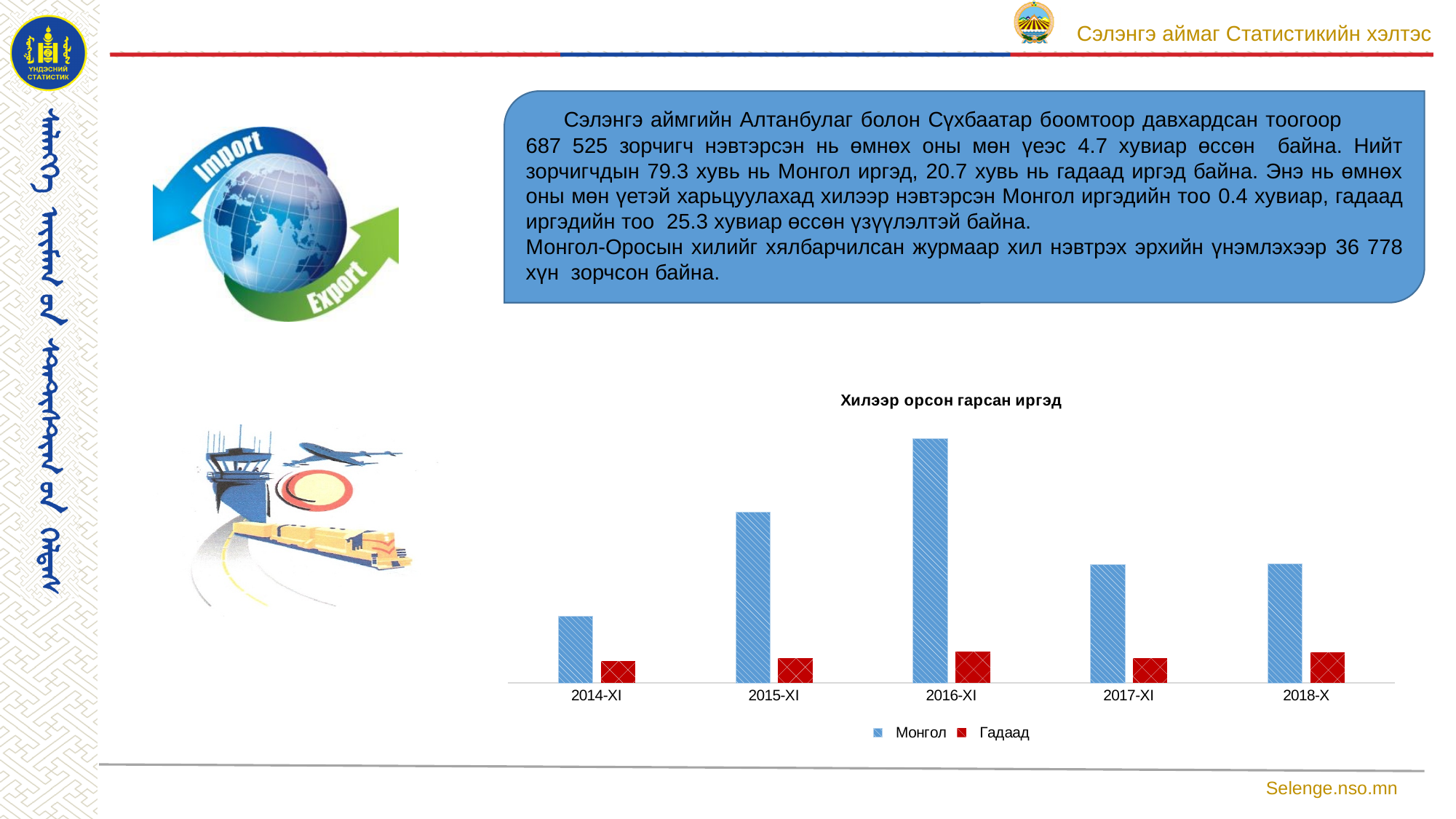
For the Монгол series, which is larger, 2014-XI or 2015-XI? 2015-XI For the Монгол series, which is larger, 2016-XI or 2017-XI? 2016-XI How many categories are shown on the x axis of the chart? 5 Does the Монгол series rise or fall from 2014-XI to 2016-XI? rise What kind of chart is shown under the title 'Хилээр орсон гарсан иргэд'? bar chart Which category has the highest value for the Монгол series? 2016-XI How many series does the legend of the chart list? 2 Which category has the lowest value for the Монгол series? 2014-XI Which series is shown in red in the chart? Гадаад What is the title of the chart? Хилээр орсон гарсан иргэд In 2016-XI, which series has the larger value, Монгол or Гадаад? Монгол Does the Монгол series rise or fall from 2016-XI to 2017-XI? fall